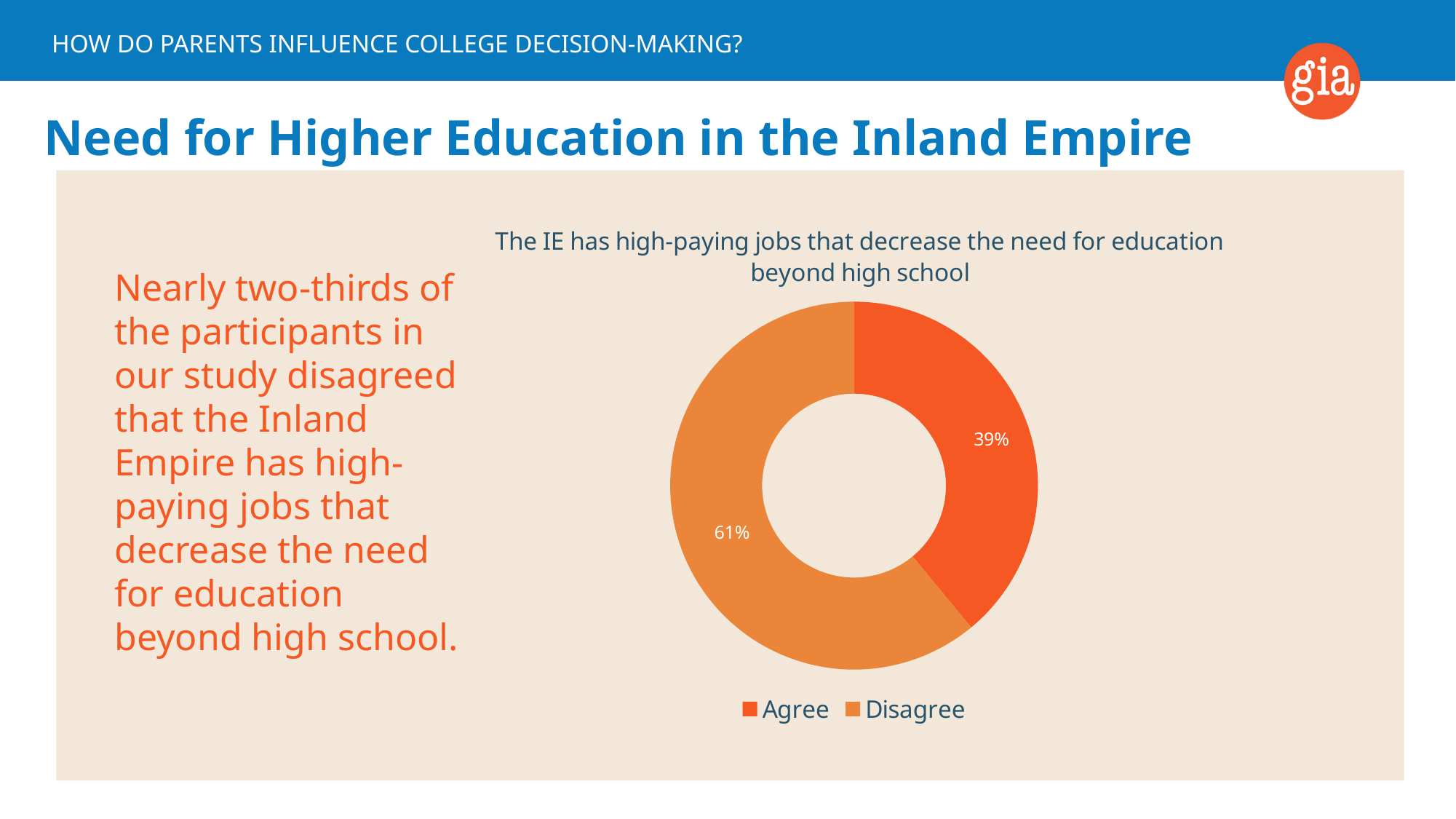
What are the two legend entries of the chart? Agree and Disagree What is the title of the chart? The IE has high-paying jobs that decrease the need for education beyond high school Is the Agree share larger or smaller than the Disagree share? smaller How many categories are shown in the chart? 2 What kind of chart is shown on the slide? Doughnut (pie) chart What is the difference in percentage points between the Disagree and Agree shares? 22 What percentage of participants disagree that the IE has high-paying jobs that decrease the need for education beyond high school? 61% Which response has the larger share of the chart, Agree or Disagree? Disagree What percentage of participants agree that the IE has high-paying jobs that decrease the need for education beyond high school? 39% What share of the chart does the Disagree slice represent? 61% Which response has the smaller share of the chart? Agree